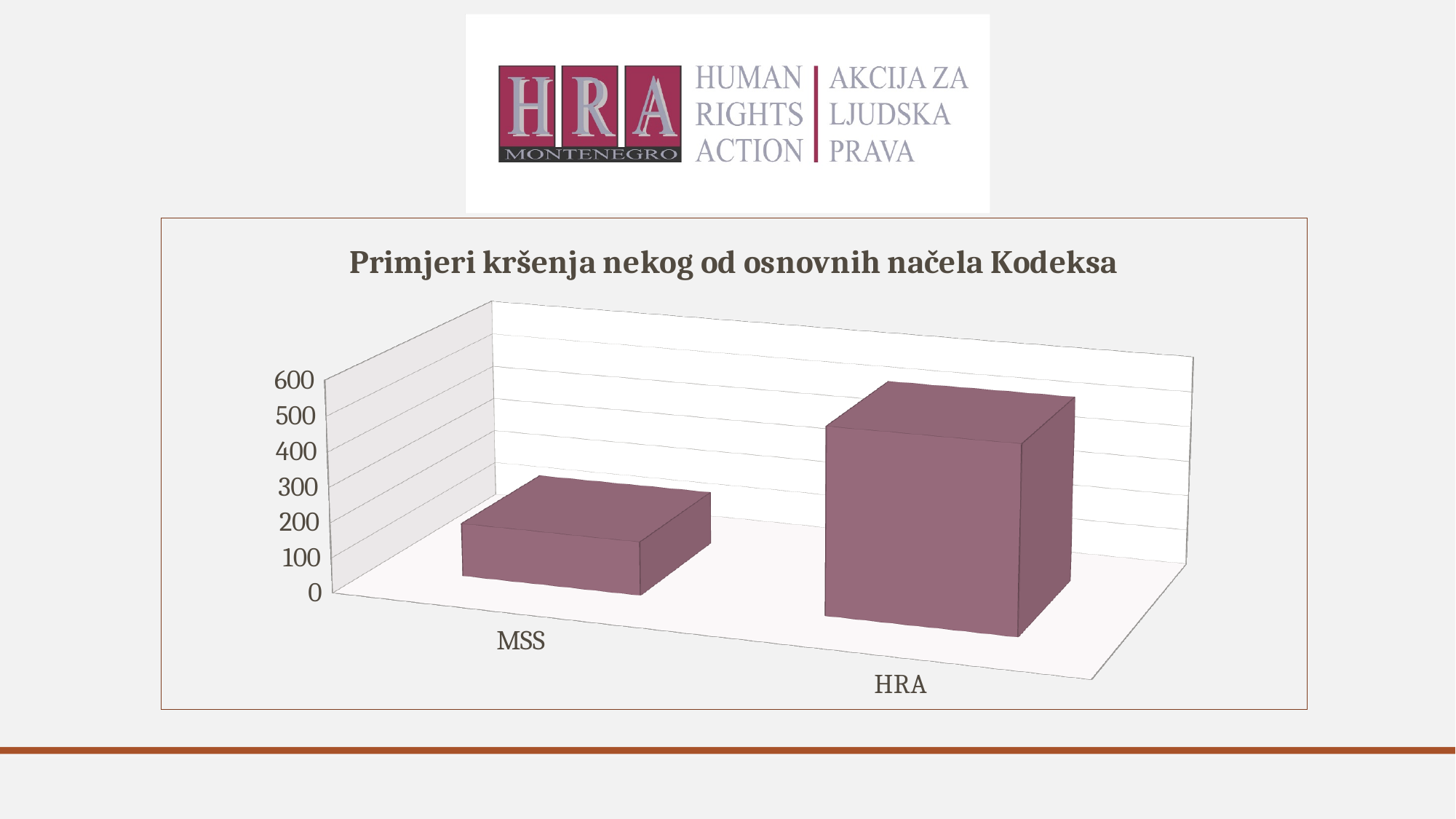
Which category has the lowest value in the chart? MSS What kind of chart is shown on the slide? bar chart Which is larger, the value for MSS or the value for HRA? HRA What is the title of the chart? Primjeri kršenja nekog od osnovnih načela Kodeksa Do the values rise or fall from MSS to HRA along the x axis? rise Is the value for HRA greater or less than 300? greater How many categories are shown on the x axis of the chart? 2 What is the highest value shown on the vertical axis of the chart? 600 Is the value for HRA greater or less than 200? greater Which category has the highest value in the chart? HRA Is the value for MSS greater or less than 300? less